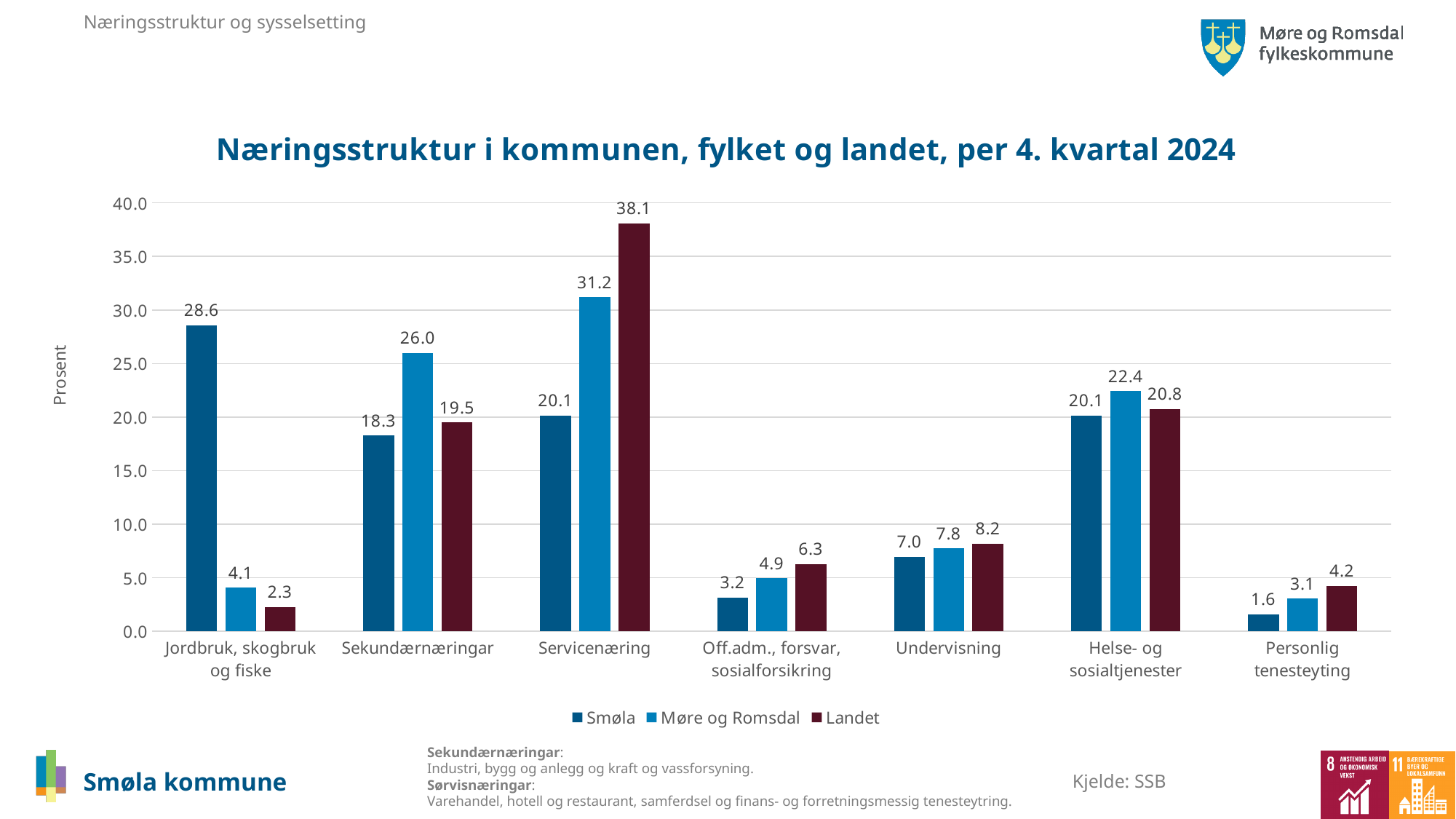
What is the title of the chart? Næringsstruktur i kommunen, fylket og landet, per 4. kvartal 2024 How many series does the legend list? 3 Which category has the highest value for Smøla? Jordbruk, skogbruk og fiske How many categories are shown on the x axis? 7 What is the value for Landet in the Servicenæring category? 38.1 What is the value for Smøla in the Jordbruk, skogbruk og fiske category? 28.6 Which is larger in the Sekundærnæringar category: Møre og Romsdal or Landet? Møre og Romsdal Which category has the lowest value for Landet? Jordbruk, skogbruk og fiske What is the value for Møre og Romsdal in the Helse- og sosialtjenester category? 22.4 What is the difference between the Landet and Smøla values in the Servicenæring category? 18.0 What kind of chart is shown on the slide? Bar chart Is the value for Møre og Romsdal in the Servicenæring category greater or less than 30.0? greater